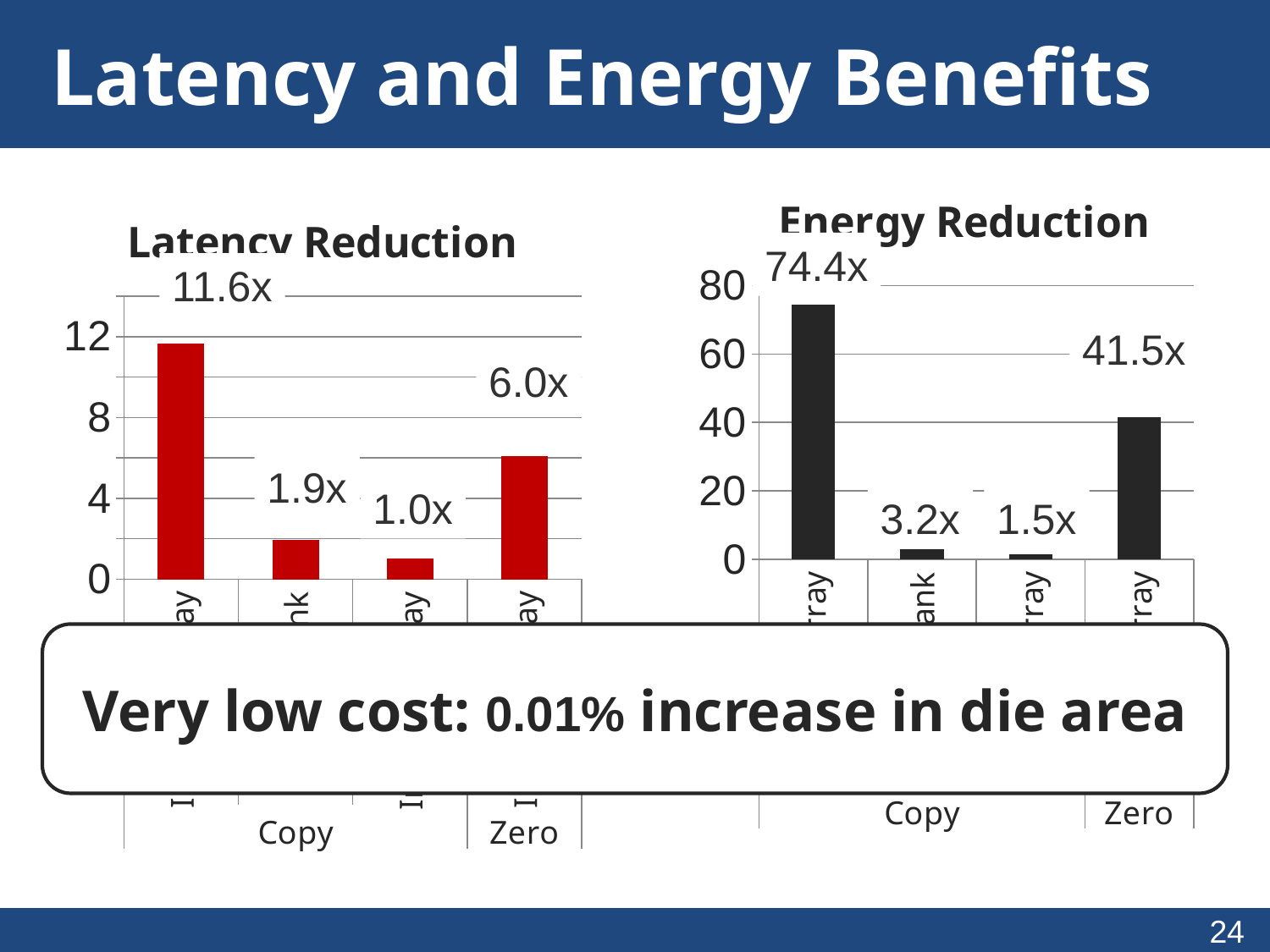
In the Energy Reduction chart, what is the value of the bar in the Zero group? 41.5x What colour are the bars in the Latency Reduction chart? red What kind of chart is the Latency Reduction chart? bar chart In the Latency Reduction chart, what is the difference between the first bar (11.6x) and the last bar (6.0x)? 5.6x In the Energy Reduction chart, is the value of the first bar greater or less than 60? greater In the Latency Reduction chart, what is the lowest value shown? 1.0x In the Latency Reduction chart, what is the value of the bar in the Zero group? 6.0x In the Latency Reduction chart, what is the highest value shown? 11.6x How many bars are plotted in the Energy Reduction chart? 4 In the Energy Reduction chart, which is larger: the first bar or the last bar? the first bar (74.4x) In the Energy Reduction chart, what is the highest value shown? 74.4x In the Energy Reduction chart, what is the lowest value shown? 1.5x